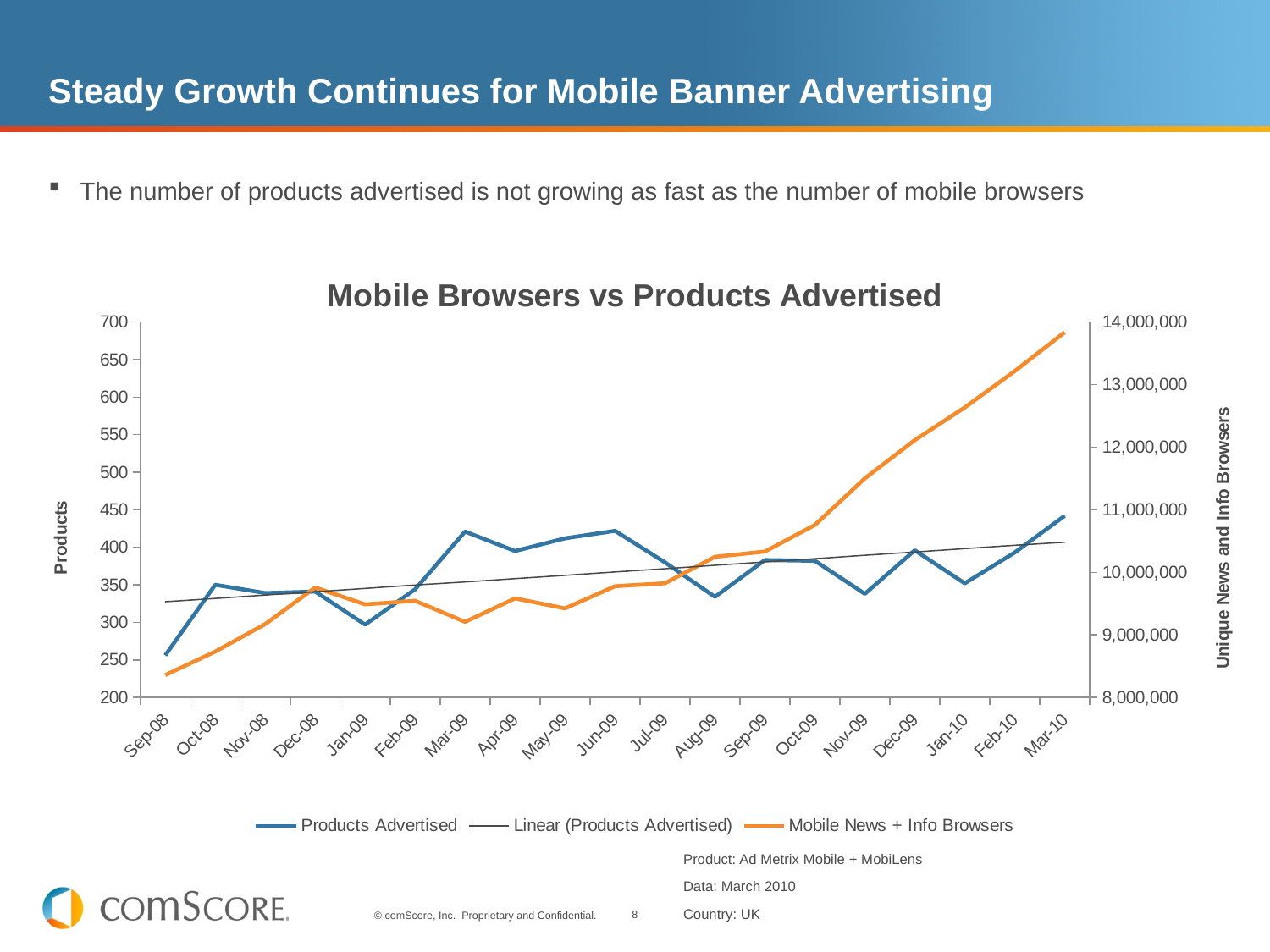
How many months are shown along the x axis of the chart? 19 Is the Mobile News + Info Browsers value for Sep-08 greater or less than 9,000,000? less Which is larger for Products Advertised: the value in Mar-09 or the value in Jan-09? Mar-09 Is the Products Advertised value for Sep-08 greater or less than 300? less In which month is the Mobile News + Info Browsers value highest? Mar-10 What kind of chart is shown on the slide? line chart Does the Mobile News + Info Browsers line generally rise or fall from Sep-08 to Mar-10? rise In which month is the Products Advertised value lowest? Sep-08 Is the Products Advertised value for Mar-10 greater or less than 400? greater How many entries does the chart legend list? 3 What is the title of the chart? Mobile Browsers vs Products Advertised